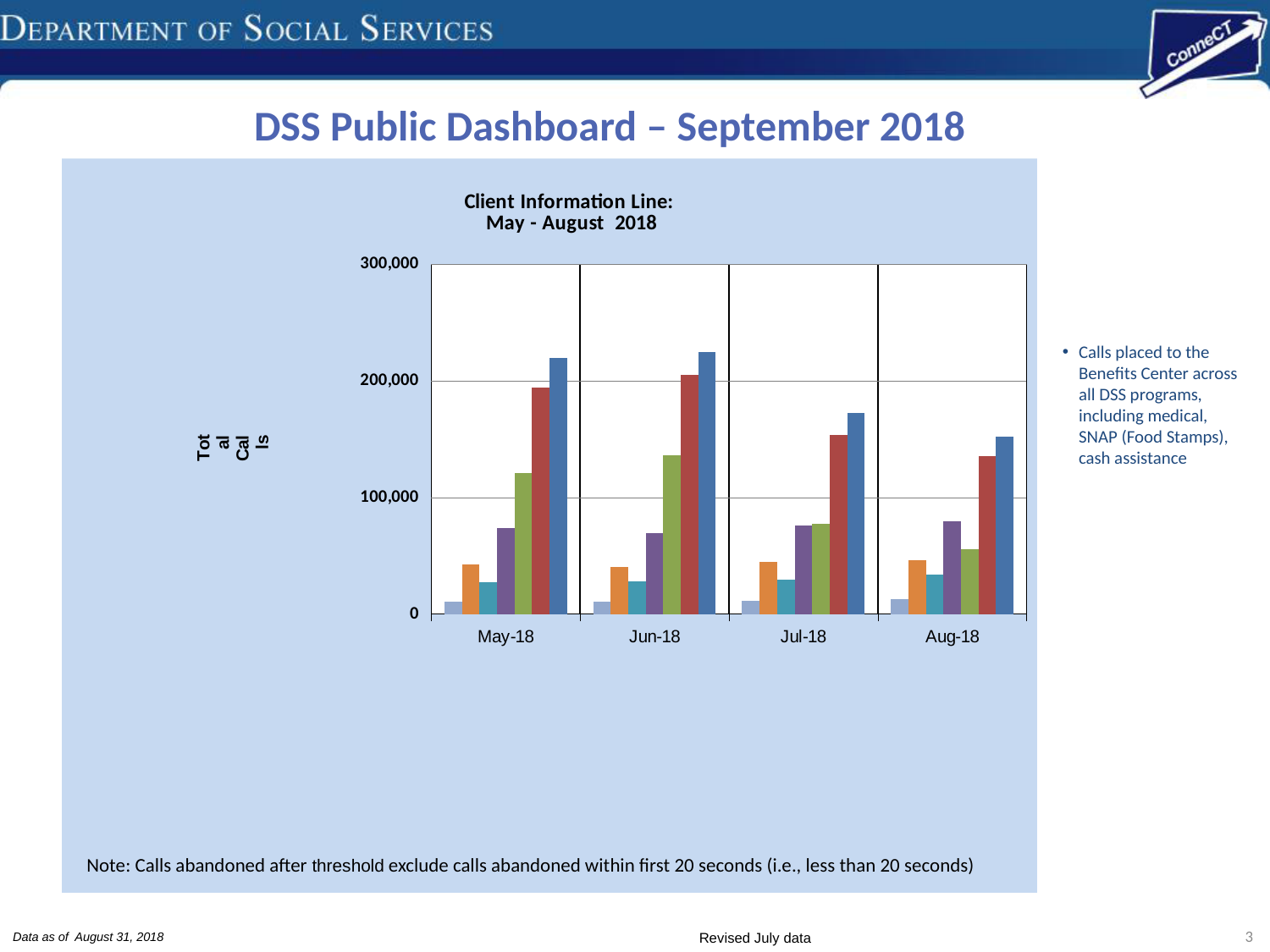
Which month has the tallest bar in the chart? Jun-18 Is the value of the green bar for May-18 greater or less than 100,000? greater Is the value of the purple bar for Aug-18 greater or less than 100,000? less Which is larger, the dark blue bar for Jun-18 or the dark blue bar for Aug-18? Jun-18 How many bars are plotted for each month in the chart? 7 How many months are shown along the x axis of the chart? 4 Is the value of the dark blue bar for Jun-18 greater or less than 200,000? greater What is the title of the chart? Client Information Line: May - August 2018 Do the dark blue bars rise or fall from Jun-18 to Aug-18? fall What kind of chart is shown on the slide? bar chart